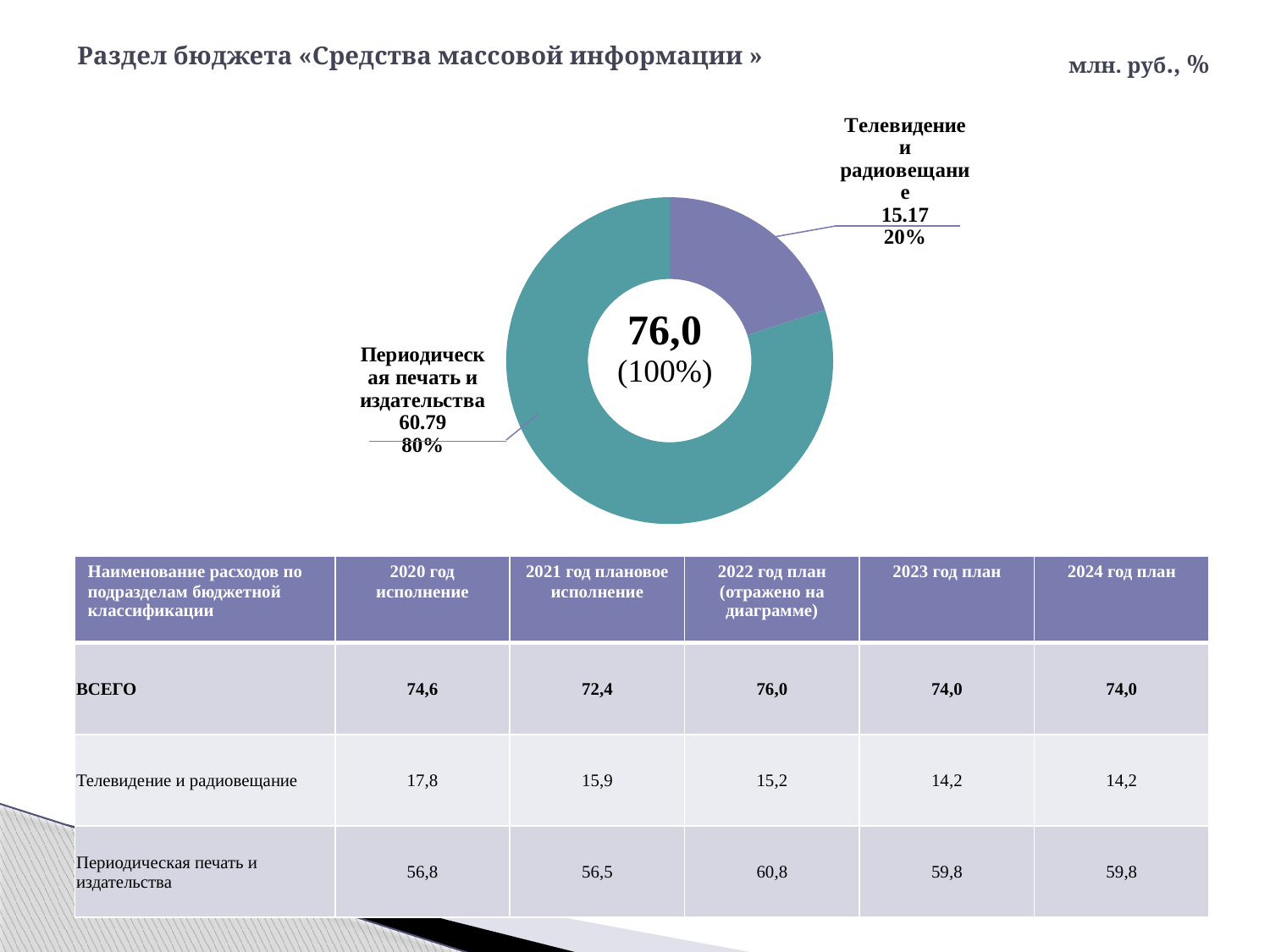
What percentage share does «Периодическая печать и издательства» have in the doughnut chart? 80% What total value is shown in the centre of the doughnut chart? 76,0 What value is shown for «Телевидение и радиовещание» on the doughnut chart? 15.17 Which is larger in the doughnut chart: «Телевидение и радиовещание» or «Периодическая печать и издательства»? Периодическая печать и издательства Which category has the smallest slice in the doughnut chart? Телевидение и радиовещание What units are indicated for the chart in the top right corner of the slide? млн. руб., % How many categories are shown in the doughnut chart? 2 Which category has the largest slice in the doughnut chart? Периодическая печать и издательства What percentage share does «Телевидение и радиовещание» have in the doughnut chart? 20% What is the difference between the values for «Периодическая печать и издательства» and «Телевидение и радиовещание» in the doughnut chart? 45.62 What kind of chart is shown on the slide? Doughnut chart What value is shown for «Периодическая печать и издательства» on the doughnut chart? 60.79